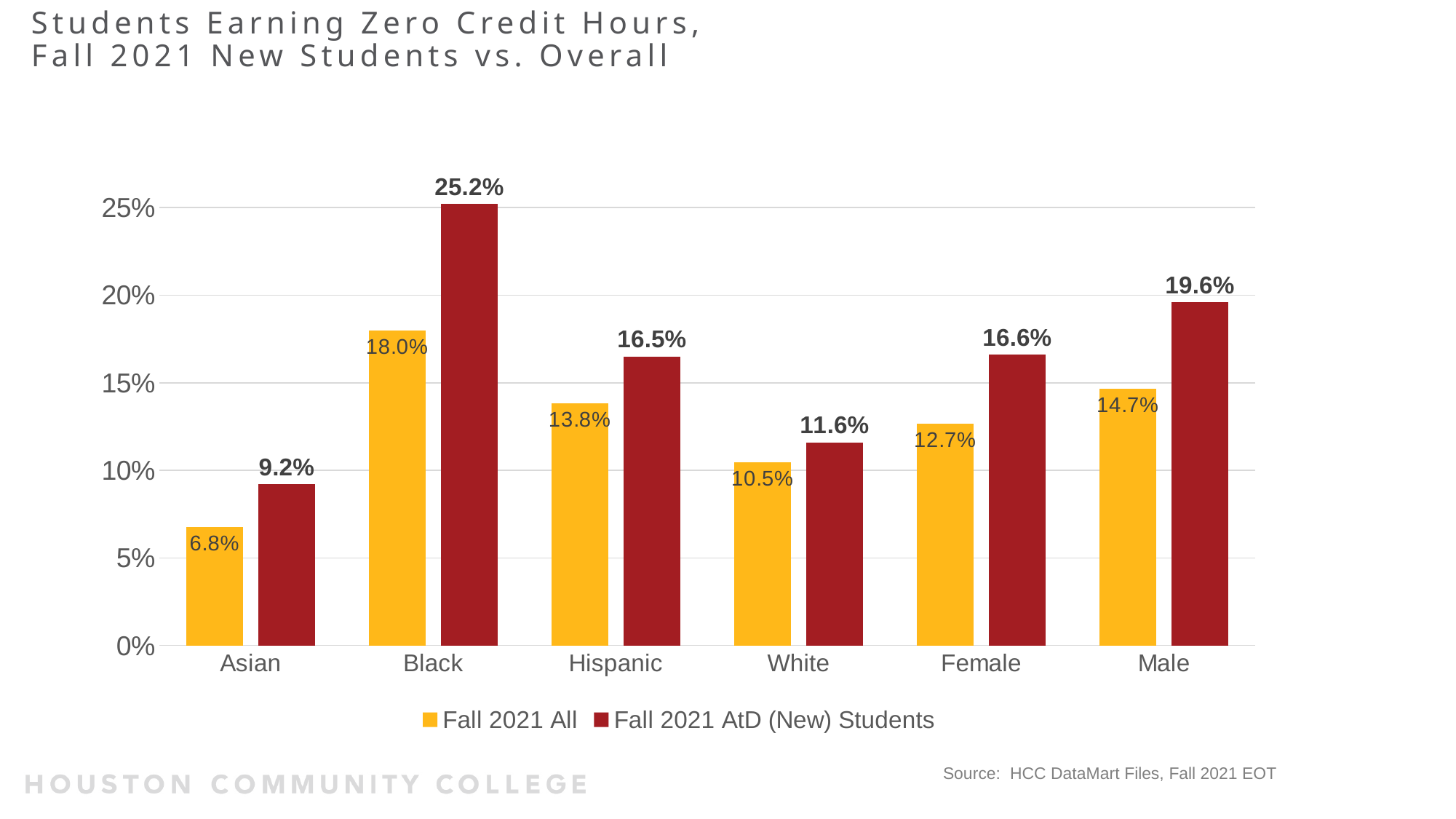
Which category has the lowest value in the Fall 2021 All series? Asian What is the value for Black in the Fall 2021 AtD (New) Students series? 25.2% What is the title of the chart? Students Earning Zero Credit Hours, Fall 2021 New Students vs. Overall Which category has the highest value in the Fall 2021 AtD (New) Students series? Black What is the value for Female in the Fall 2021 AtD (New) Students series? 16.6% Is the Fall 2021 AtD (New) Students value for White greater or less than 15%? less How many categories are shown on the x axis? 6 What kind of chart is shown on the slide? bar chart What is the difference between the Fall 2021 AtD (New) Students value and the Fall 2021 All value for Black? 7.2% Which is larger for Male: the Fall 2021 All value or the Fall 2021 AtD (New) Students value? Fall 2021 AtD (New) Students How many series does the legend list? 2 What is the value for Asian in the Fall 2021 All series? 6.8%